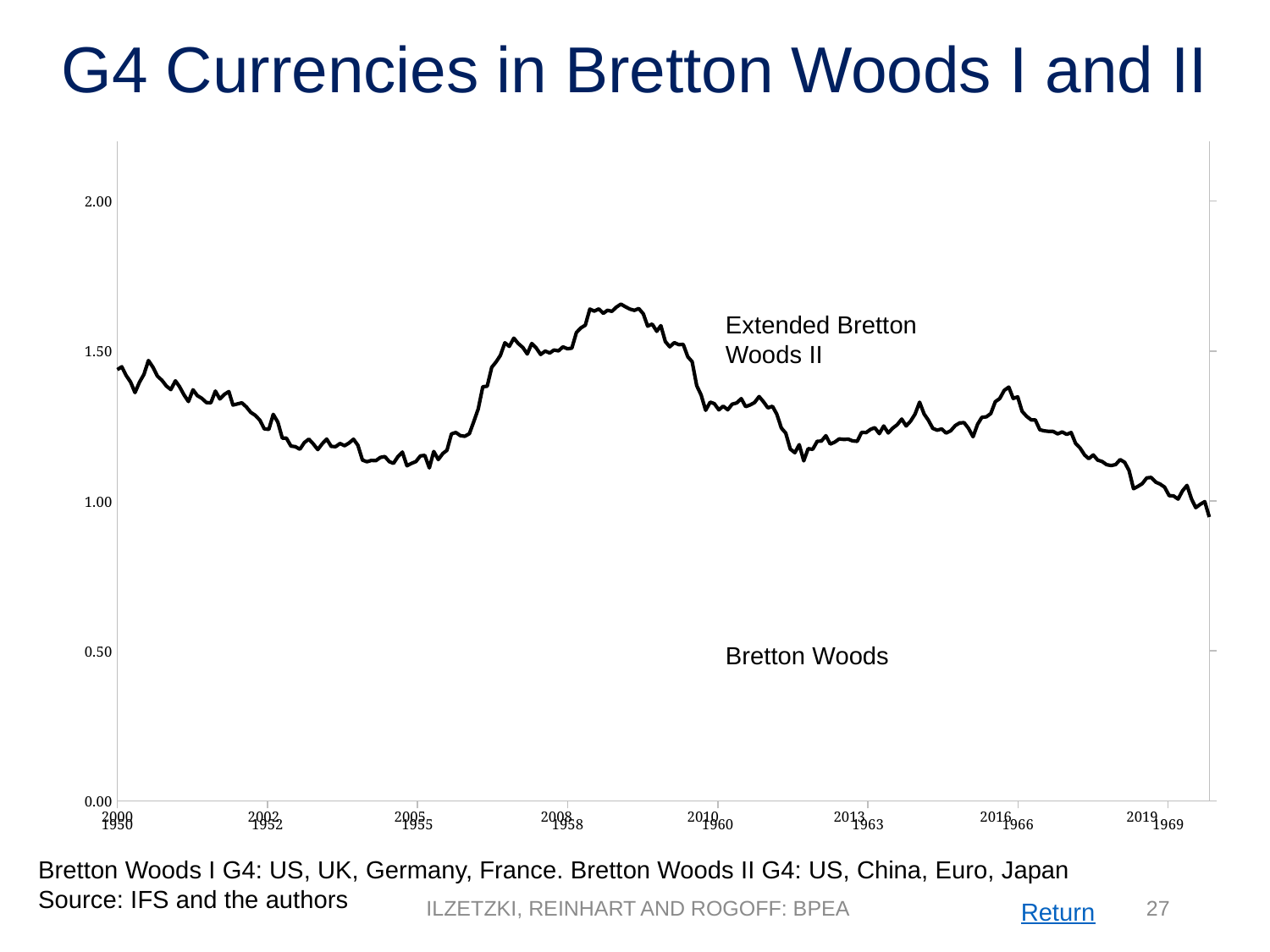
Is the peak value of the line around 2008–2009 greater or less than 1.50? greater Is the value of the line at the start of the series (2000) greater or less than 1.00? greater Is the value of the line around 2005 greater or less than 1.50? less Does the line rise or fall between 2016 and 2019? fall Is the value of the line around 2008 larger or smaller than the value around 2019? larger What kind of chart is shown on the slide? line chart What is the highest value shown on the vertical axis? 2.00 Does the line rise or fall between 2000 and 2002? fall What is the title of the chart on the slide? G4 Currencies in Bretton Woods I and II Does the line rise or fall between 2005 and 2008? rise